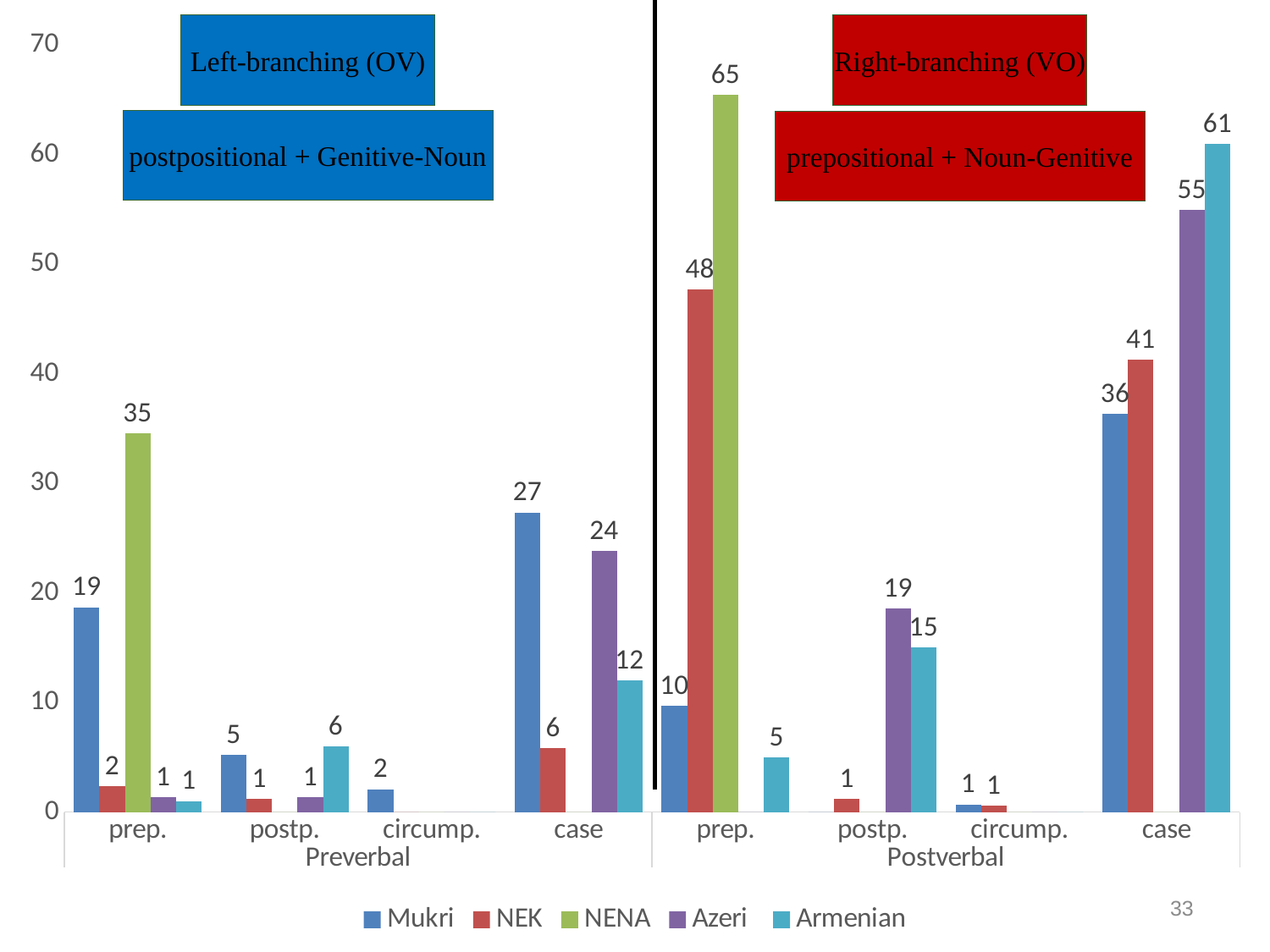
Which series is shown in green in the legend? NENA Which is larger: the NEK value for Postverbal case or the Mukri value for Postverbal case? NEK What is the value for Azeri in the Postverbal postp. category? 19 What kind of chart is shown on the slide? bar chart Is the value for NEK in the Postverbal prep. category greater or less than 40? greater What is the value for NENA in the Postverbal prep. category? 65 What is the value for Mukri in the Preverbal case category? 27 What is the difference between the Armenian and Azeri values in the Postverbal case category? 6 What is the difference between the NENA values for Postverbal prep. and Preverbal prep.? 30 Which series has the highest value in the Postverbal case category? Armenian How many series does the legend list? 5